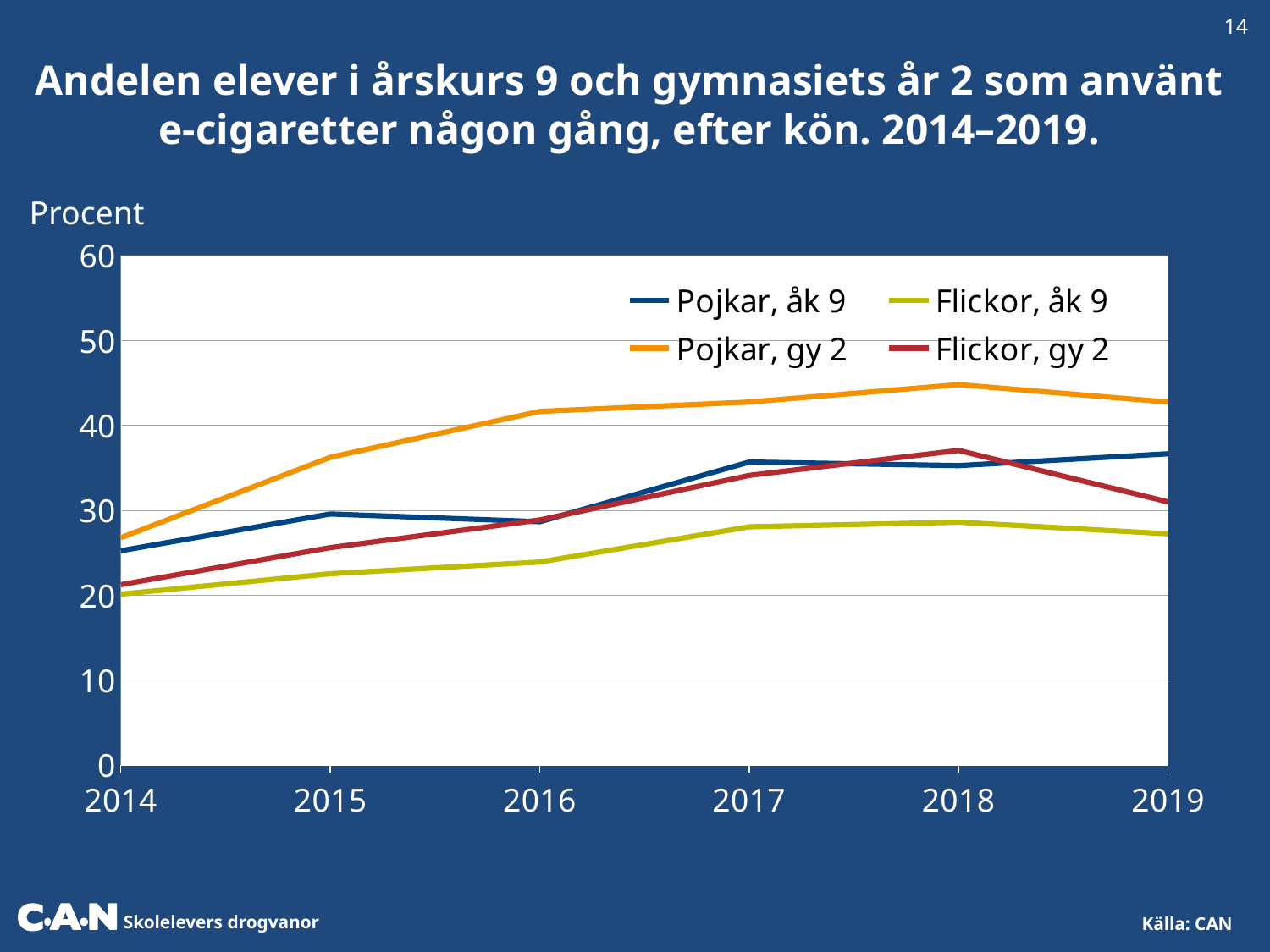
Is the value for Flickor, åk 9 in 2014 greater or less than 30? less Which series has the highest value in 2019? Pojkar, gy 2 What is the label shown above the y axis? Procent Is the value for Pojkar, gy 2 in 2018 greater or less than 40? greater In 2019, which is larger: Pojkar, åk 9 or Flickor, gy 2? Pojkar, åk 9 What kind of chart is shown on the slide? line chart Does the Pojkar, gy 2 line rise or fall from 2014 to 2018? rises Does the Flickor, gy 2 line rise or fall from 2018 to 2019? falls How many years are shown on the x axis? 6 Which series has the lowest value in 2014? Flickor, åk 9 Is the value for Flickor, gy 2 in 2019 greater or less than 40? less How many series does the legend list? 4